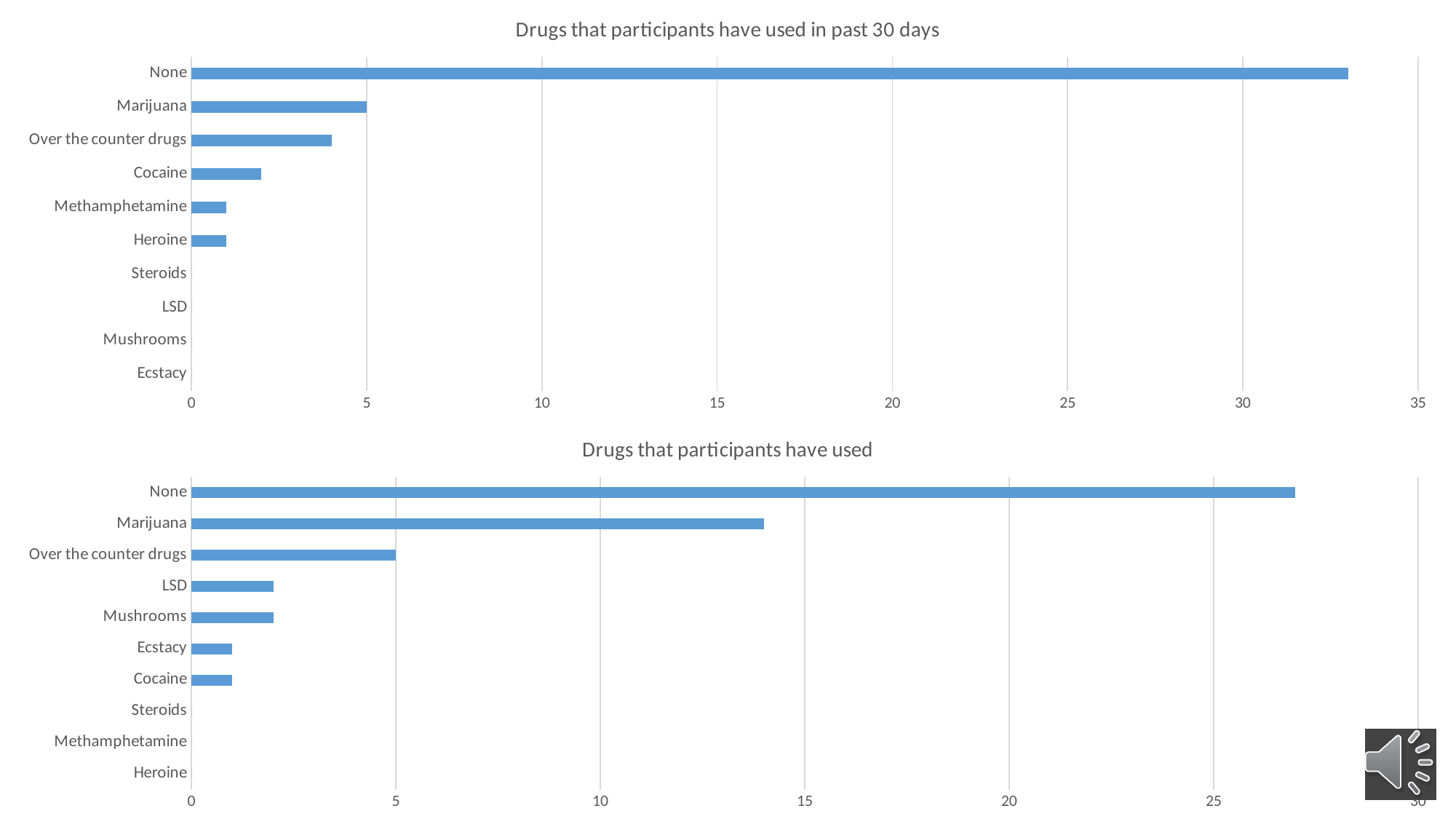
In the bottom chart, which is larger, the value for Marijuana or the value for Over the counter drugs? Marijuana What is the title of the top chart on the slide? Drugs that participants have used in past 30 days How many categories are shown in the chart titled 'Drugs that participants have used in past 30 days'? 10 In the chart titled 'Drugs that participants have used', which category has the highest value? None In the chart titled 'Drugs that participants have used in past 30 days', which category has the highest value? None In the bottom chart, is the value for None greater or less than 25? greater In the top chart, is the value for None greater or less than 30? greater In the top chart, what is the value for Marijuana? 5 In the bottom chart, is the value for Marijuana greater or less than 10? greater What kind of chart is the chart titled 'Drugs that participants have used'? bar chart In the bottom chart, what is the value for Over the counter drugs? 5